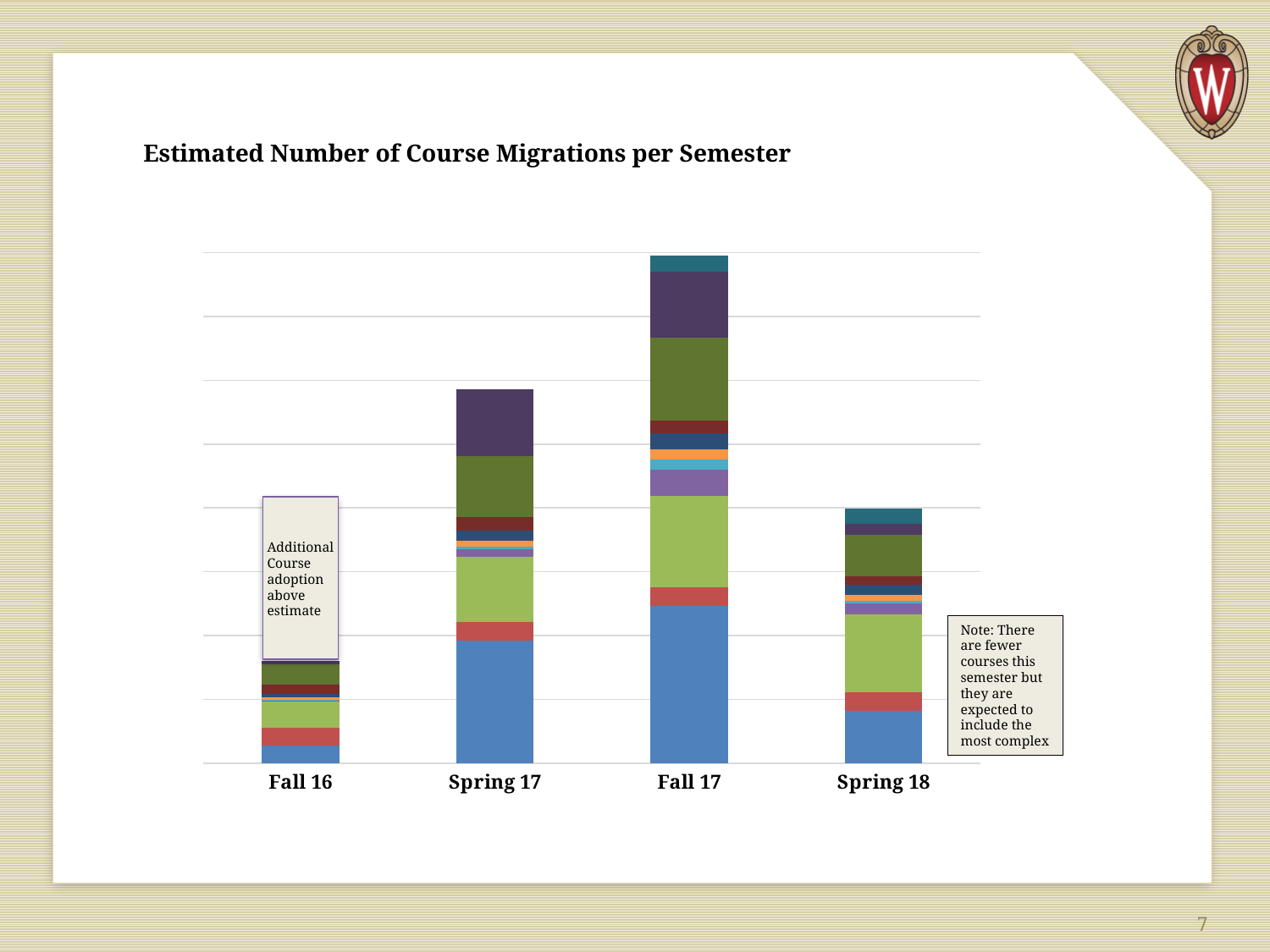
Does the total bar height rise or fall from Fall 16 to Fall 17? rise What is the title of the chart? Estimated Number of Course Migrations per Semester Which semester has the shortest bar in the chart? Fall 16 Which bar is taller, Fall 16 or Spring 18? Spring 18 What kind of chart is shown on the slide? stacked bar chart Which semester has the largest blue bottom segment in the chart? Fall 17 Which semester has the tallest bar in the chart? Fall 17 Which bar is taller, Spring 17 or Spring 18? Spring 17 Which bar is taller, Fall 17 or Spring 17? Fall 17 Does the total bar height rise or fall from Fall 17 to Spring 18? fall Which semester's bar has the annotation 'Additional Course adoption above estimate' placed above it? Fall 16 How many semesters are shown on the x axis of the chart? 4